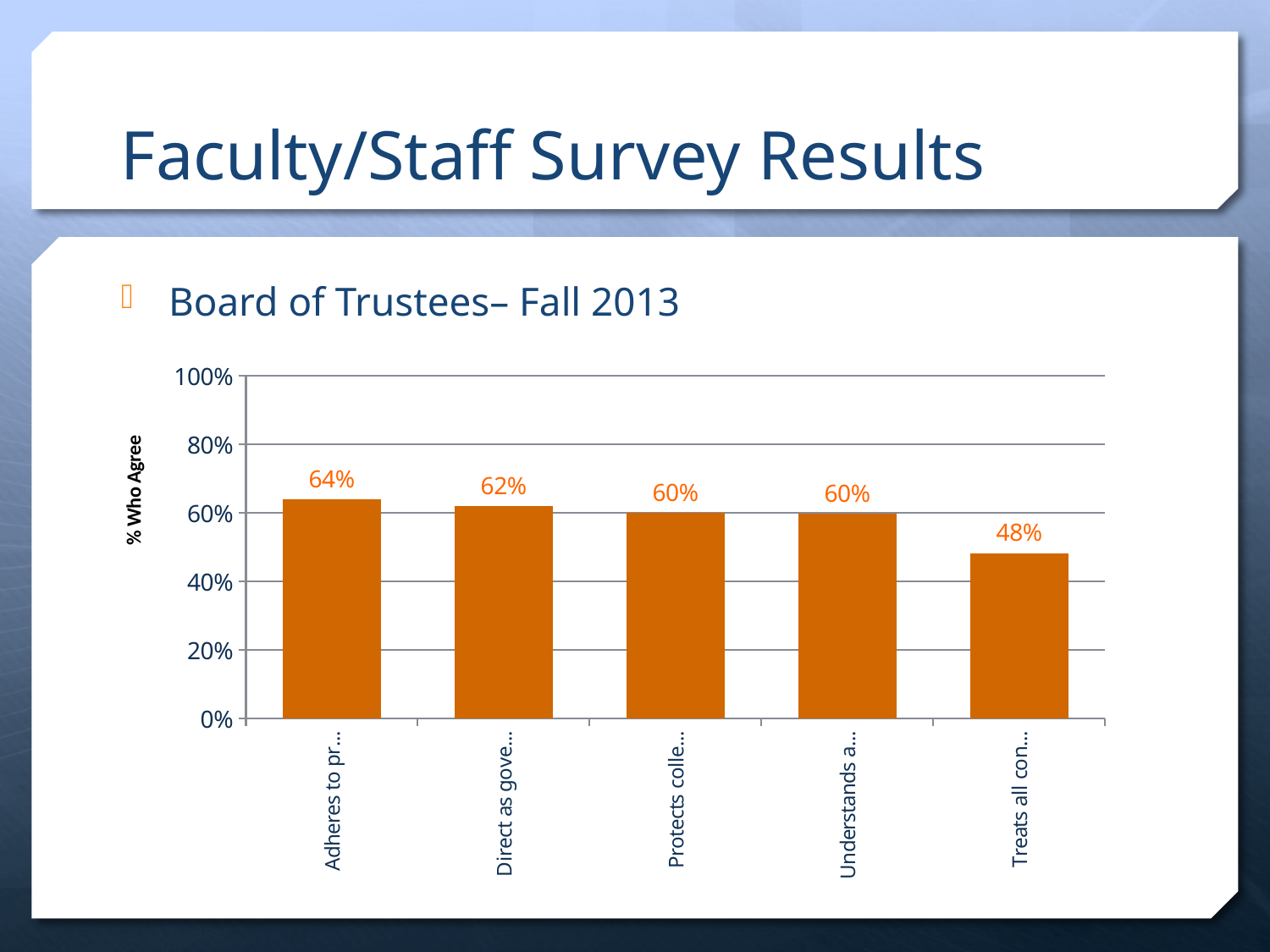
What is the value of the last bar, labelled "Treats all con..."? 48% What is the label on the vertical axis of the chart? % Who Agree Is the value for "Treats all con..." greater or less than 60%? less Which category has the lowest percentage who agree? Treats all con... What kind of chart is shown on the slide? bar chart What is the value of the first bar, labelled "Adheres to pr..."? 64% Which category has the highest percentage who agree? Adheres to pr... Which is larger, the value for "Adheres to pr..." or the value for "Direct as gove..."? Adheres to pr... What is the value of the bar labelled "Protects colle..."? 60% What is the difference between the highest bar (64%) and the lowest bar (48%)? 16% What is the value of the bar labelled "Direct as gove..."? 62% How many bars are plotted in the chart? 5